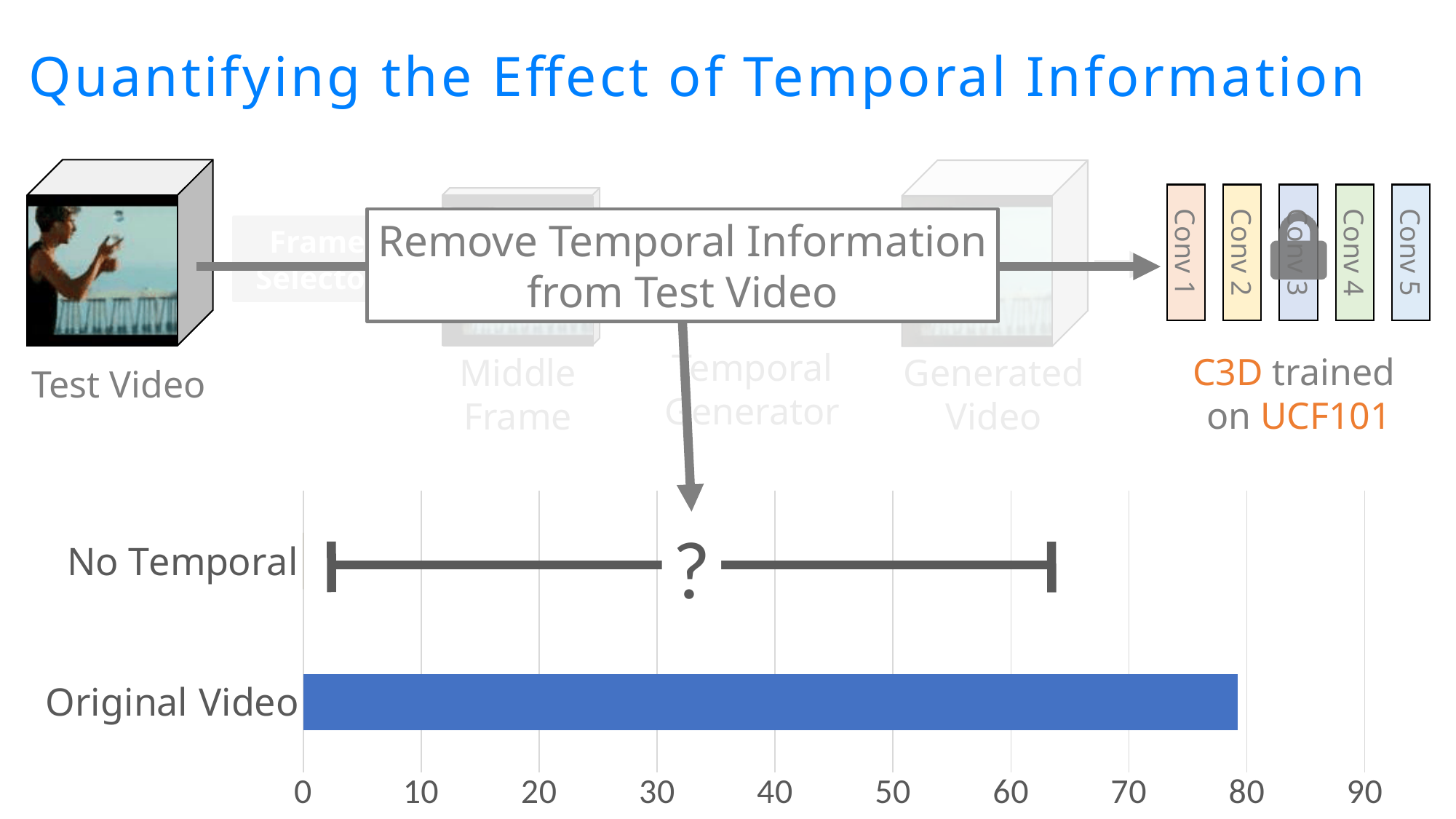
What is the highest tick value shown on the horizontal axis of the bar chart? 90 How many categories are listed on the vertical axis of the bar chart? 2 Is the value for Original Video greater or less than 70? greater What is the lowest tick value shown on the horizontal axis of the bar chart? 0 Is the value for Original Video greater or less than 50? greater What kind of chart is shown at the bottom of the slide? bar chart Is the value for Original Video greater or less than 90? less Which category in the bar chart has no bar plotted and is marked with a question mark instead? No Temporal